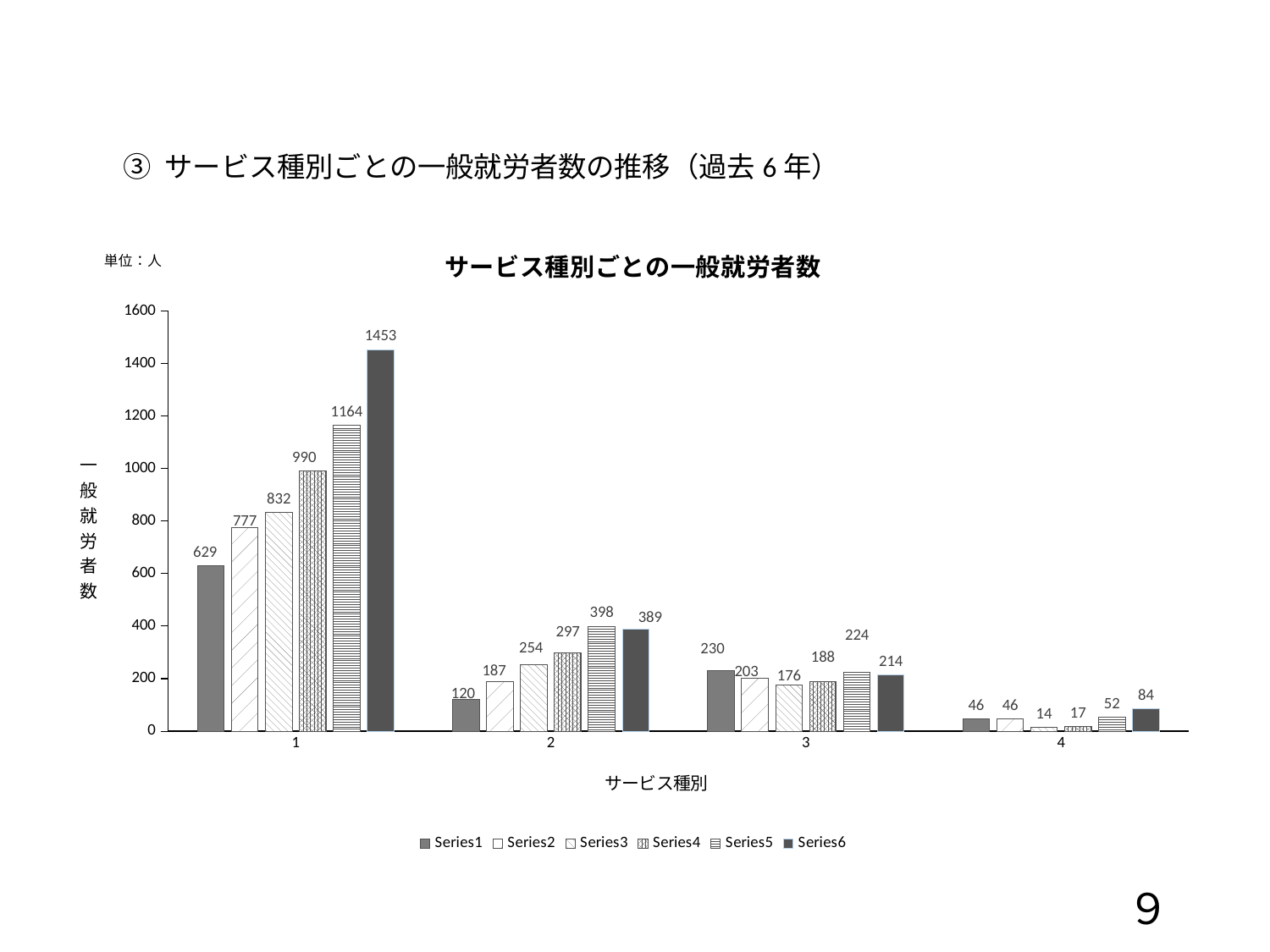
What is the title of the chart? サービス種別ごとの一般就労者数 What is the value of Series6 for category 1? 1453 What is the value of Series3 for category 4? 14 Which category has the highest value for Series6? 1 How many series does the legend list? 6 For category 2, which is larger: Series5 or Series6? Series5 How many categories are shown on the x axis? 4 Which series has the lowest value for category 4? Series3 What is the value of Series5 for category 3? 224 What kind of chart is shown on the slide? bar chart What is the difference between the Series6 and Series1 values for category 1? 824 What is the value of Series1 for category 2? 120